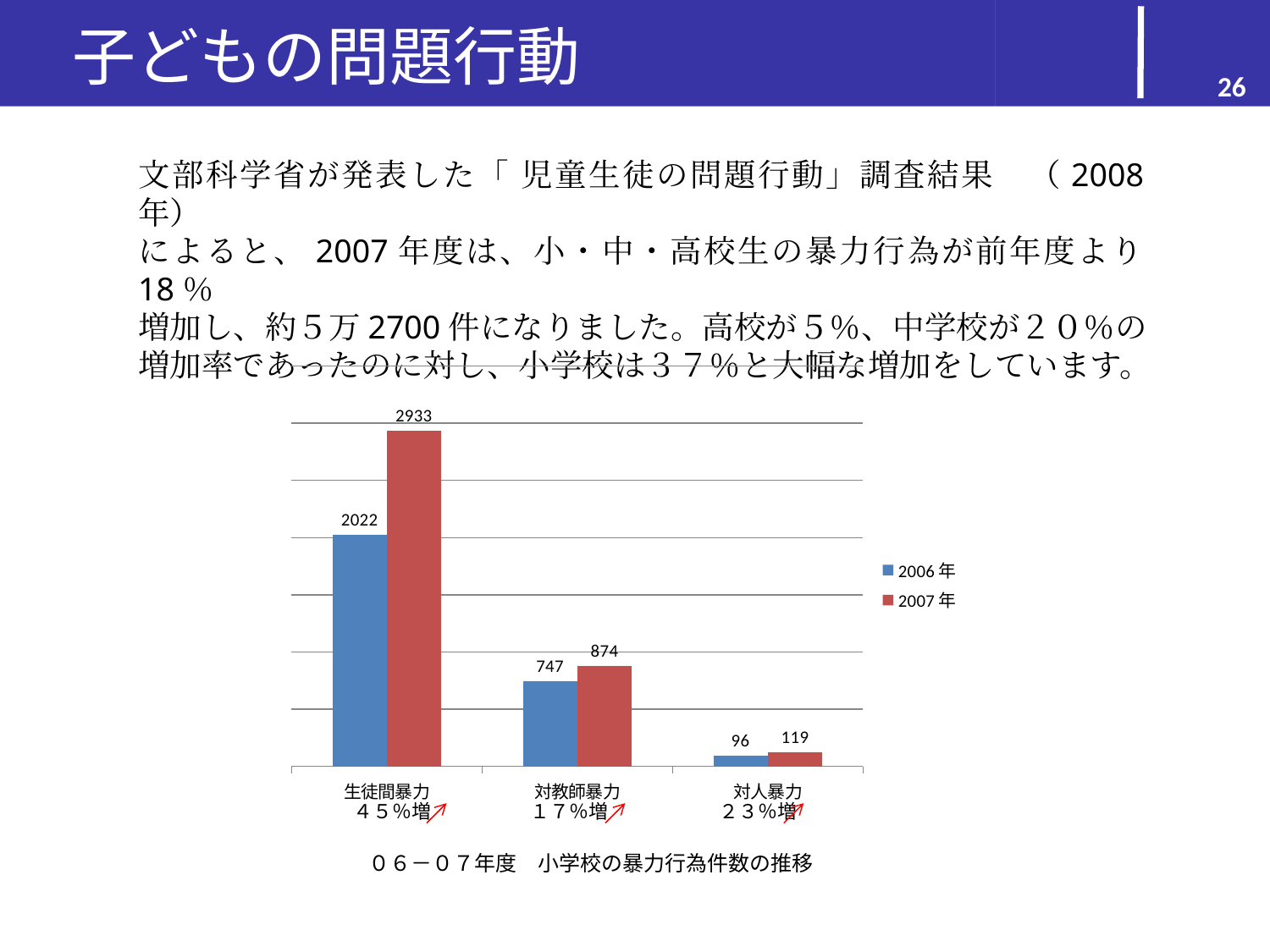
Which category has the highest value in the 2007年 series? 生徒間暴力 What is the caption written below the chart? ０６－０７年度 小学校の暴力行為件数の推移 How many categories are shown on the x axis of the chart? 3 What is the value for 生徒間暴力 in the 2007年 series? 2933 What is the value for 対人暴力 in the 2007年 series? 119 What is the difference between the 2007年 and 2006年 values for 生徒間暴力? 911 What is the value for 対教師暴力 in the 2006年 series? 747 How many series does the legend list? 2 What is the difference between the 2007年 and 2006年 values for 対教師暴力? 127 What kind of chart is shown on the slide? Bar chart Which is larger for 対人暴力: the 2006年 value or the 2007年 value? 2007年 Which category has the lowest value in the 2006年 series? 対人暴力